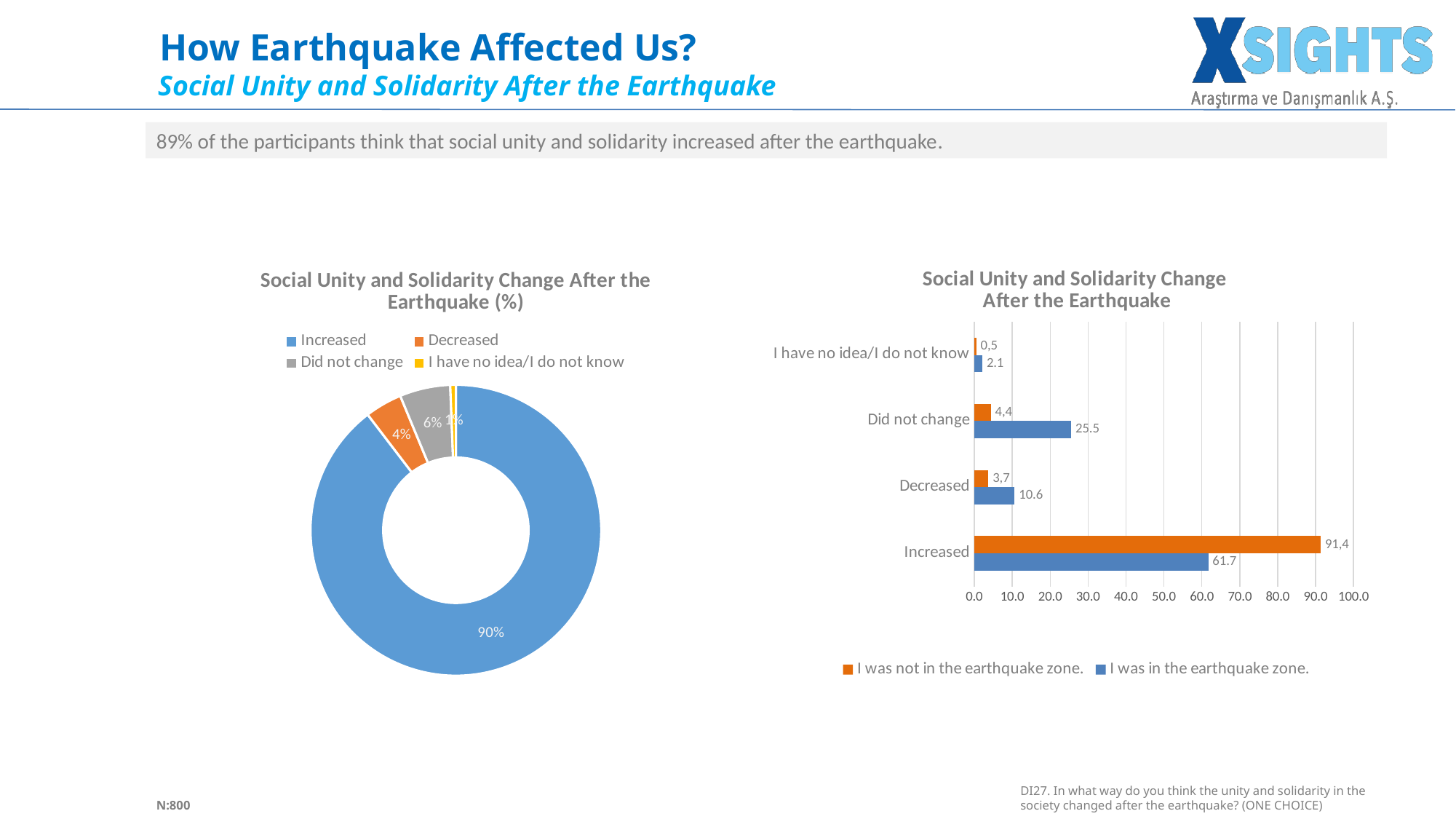
In the bar chart on the right, which category has the highest value for the series 'I was in the earthquake zone.'? Increased In the doughnut chart on the left, what percentage is shown for Did not change? 6% In the bar chart on the right, how many series does the legend list? 2 In the bar chart on the right, which series is shown in orange? I was not in the earthquake zone. In the doughnut chart on the left, how many categories does the legend list? 4 In the doughnut chart on the left, what share of participants said social unity and solidarity Increased? 90% What kind of chart is the chart on the right? Bar chart In the bar chart on the right, what is the value for Did not change for the series 'I was in the earthquake zone.'? 25.5 In the doughnut chart on the left, which category has the smallest slice? I have no idea/I do not know In the bar chart on the right, what is the value for Increased for the series 'I was not in the earthquake zone.'? 91,4 In the bar chart on the right, which is larger for Did not change: 'I was not in the earthquake zone.' or 'I was in the earthquake zone.'? I was in the earthquake zone. In the bar chart on the right, what is the value for Decreased for the series 'I was in the earthquake zone.'? 10.6